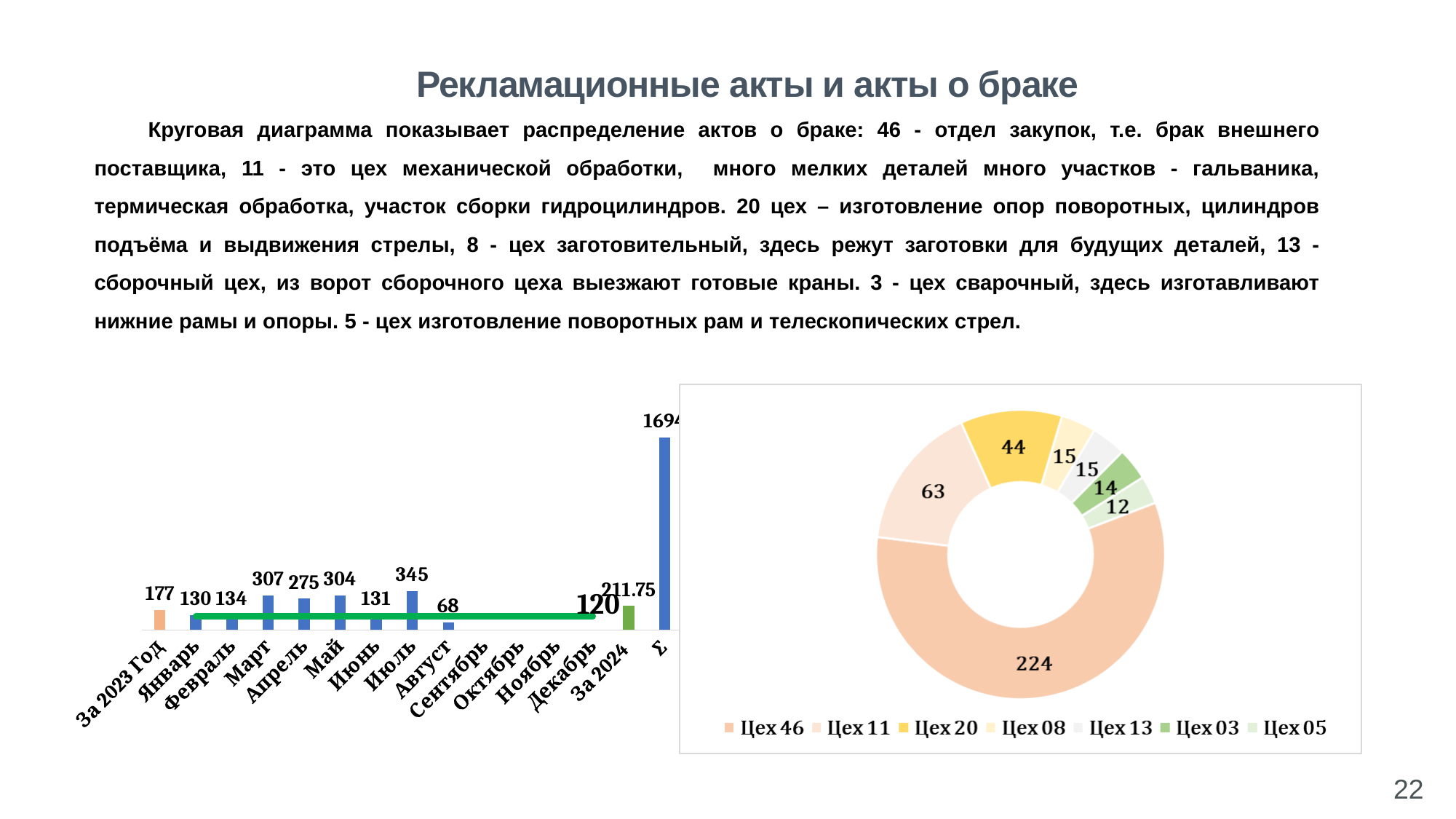
In the bar chart on the left, what is the difference between the values for Июль and Август? 277 In the donut chart on the right, what is the value for Цех 20? 44 In the bar chart on the left, what is the value for Март? 307 In the donut chart on the right, which category has the largest value? Цех 46 What kind of chart is the chart on the left? Combination bar and line chart How many entries does the legend of the donut chart on the right list? 7 In the donut chart on the right, what is the value for Цех 46? 224 In the bar chart on the left, which month from Январь to Август has the highest value? Июль In the bar chart on the left, what is the value for За 2024? 211.75 In the bar chart on the left, which is larger, the value for Март or the value for Май? Март In the bar chart on the left, which month from Январь to Август has the lowest value? Август In the bar chart on the left, what is the value for Август? 68